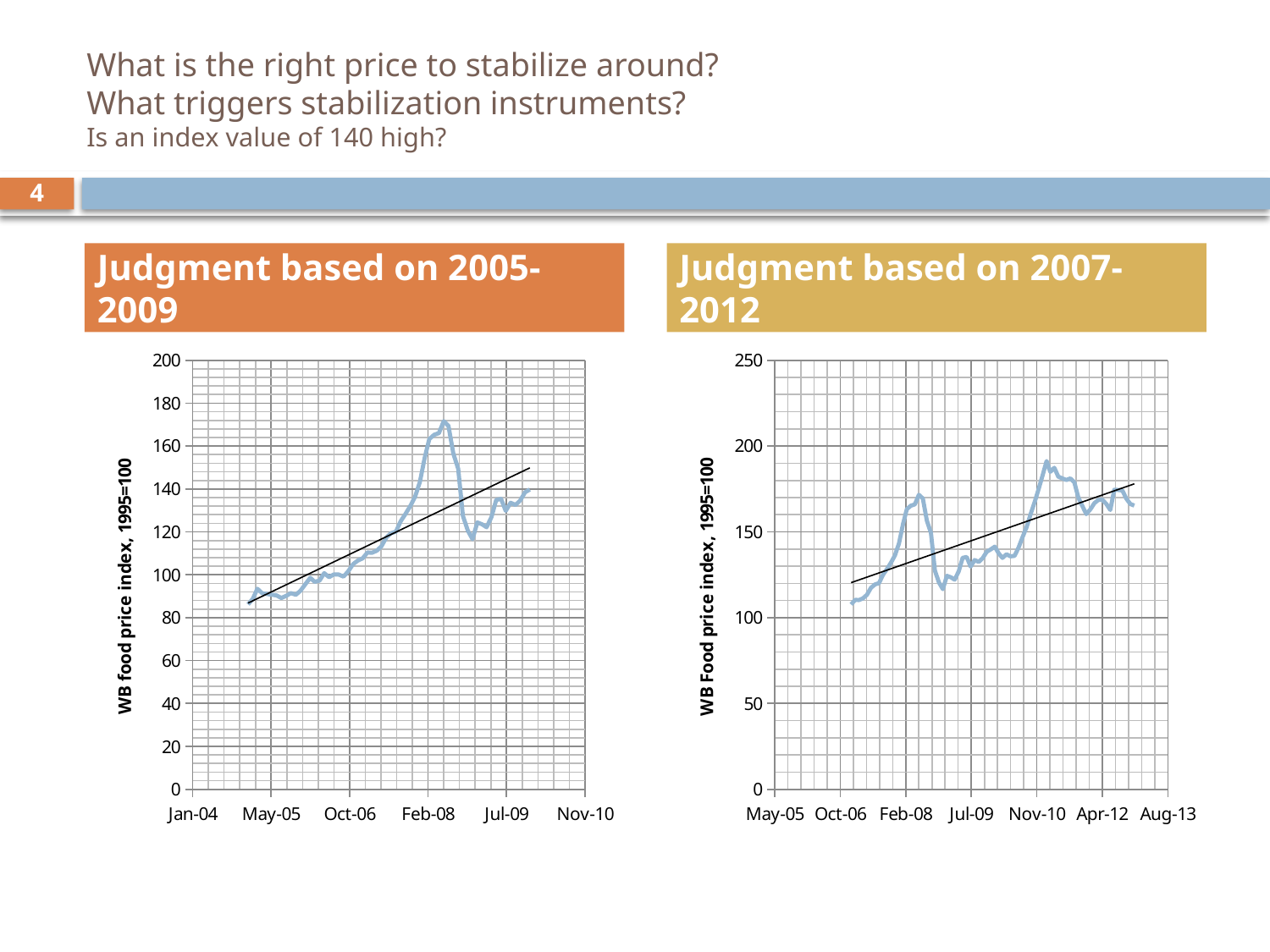
In the chart titled "Judgment based on 2007-2012", does the fitted trend line rise or fall from left to right? rise In the chart titled "Judgment based on 2007-2012", what is the highest value shown on the vertical axis? 250 In the chart titled "Judgment based on 2005-2009", is the food price index at the start of the series (around early 2005) greater or less than 100? less In the chart titled "Judgment based on 2005-2009", does the fitted trend line rise or fall from left to right? rise In the chart titled "Judgment based on 2007-2012", is the food price index at the start of the series (around late 2006) greater or less than 150? less In the chart titled "Judgment based on 2005-2009", what kind of chart is shown? line chart How many charts are shown on the slide? 2 In the chart titled "Judgment based on 2005-2009", is the peak of the food price index around Feb-08 greater or less than 160? greater In the chart titled "Judgment based on 2007-2012", what kind of chart is shown? line chart In the chart titled "Judgment based on 2005-2009", what is the highest value shown on the vertical axis? 200 In the chart titled "Judgment based on 2005-2009", what is the label on the vertical axis? WB food price index, 1995=100